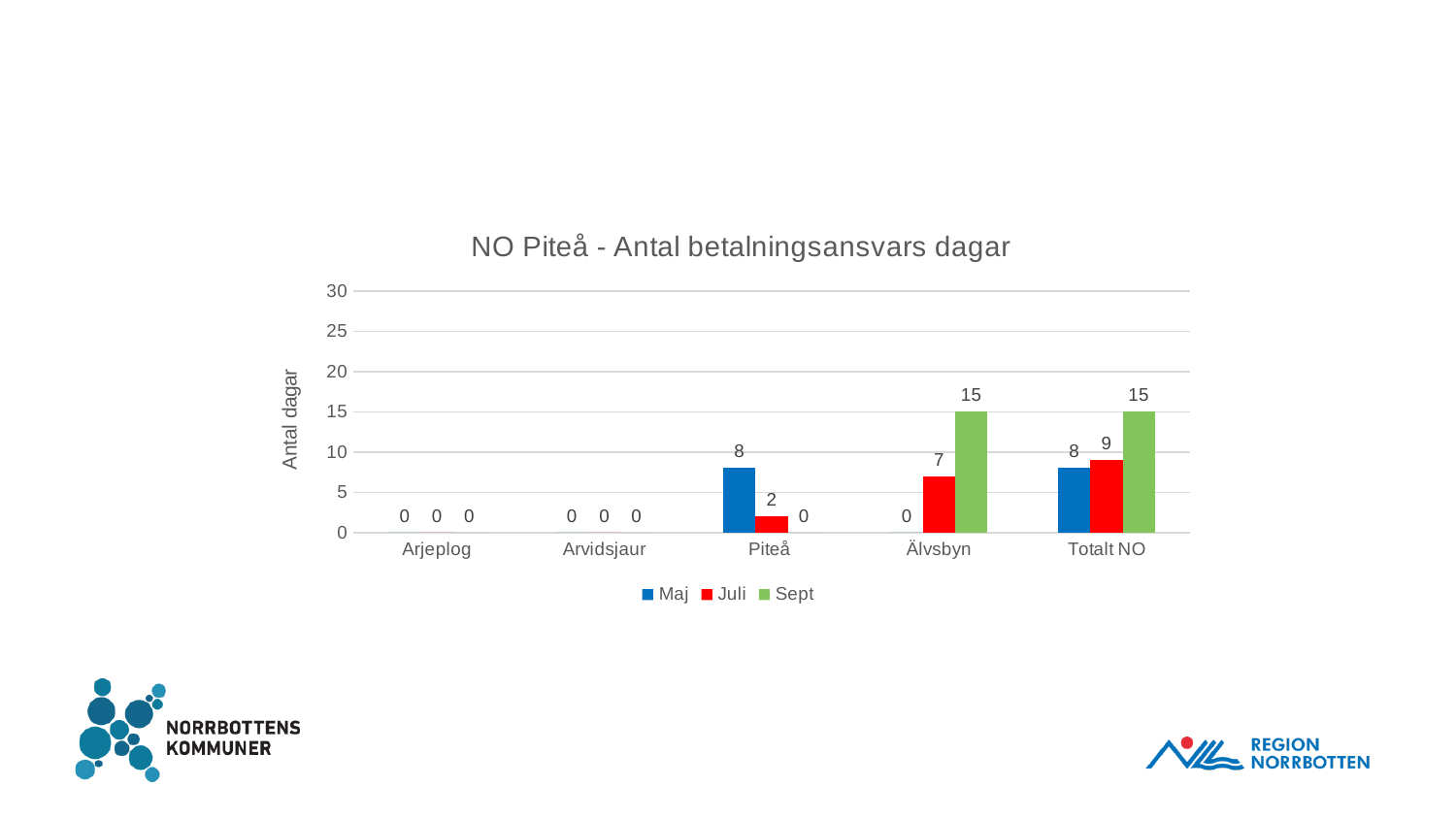
What is the difference between the Sept and Juli values for Älvsbyn? 8 What is the title of the chart? NO Piteå - Antal betalningsansvars dagar Which is larger for Piteå: the Maj value or the Juli value? Maj What is the value for Totalt NO in the Juli series? 9 What is the value for Piteå in the Juli series? 2 Which category has the highest value in the Juli series? Totalt NO How many categories are shown on the x axis? 5 What is the value for Älvsbyn in the Sept series? 15 How many series does the legend list? 3 What is the label on the vertical axis? Antal dagar What is the value for Piteå in the Maj series? 8 What kind of chart is shown on the slide? Bar chart